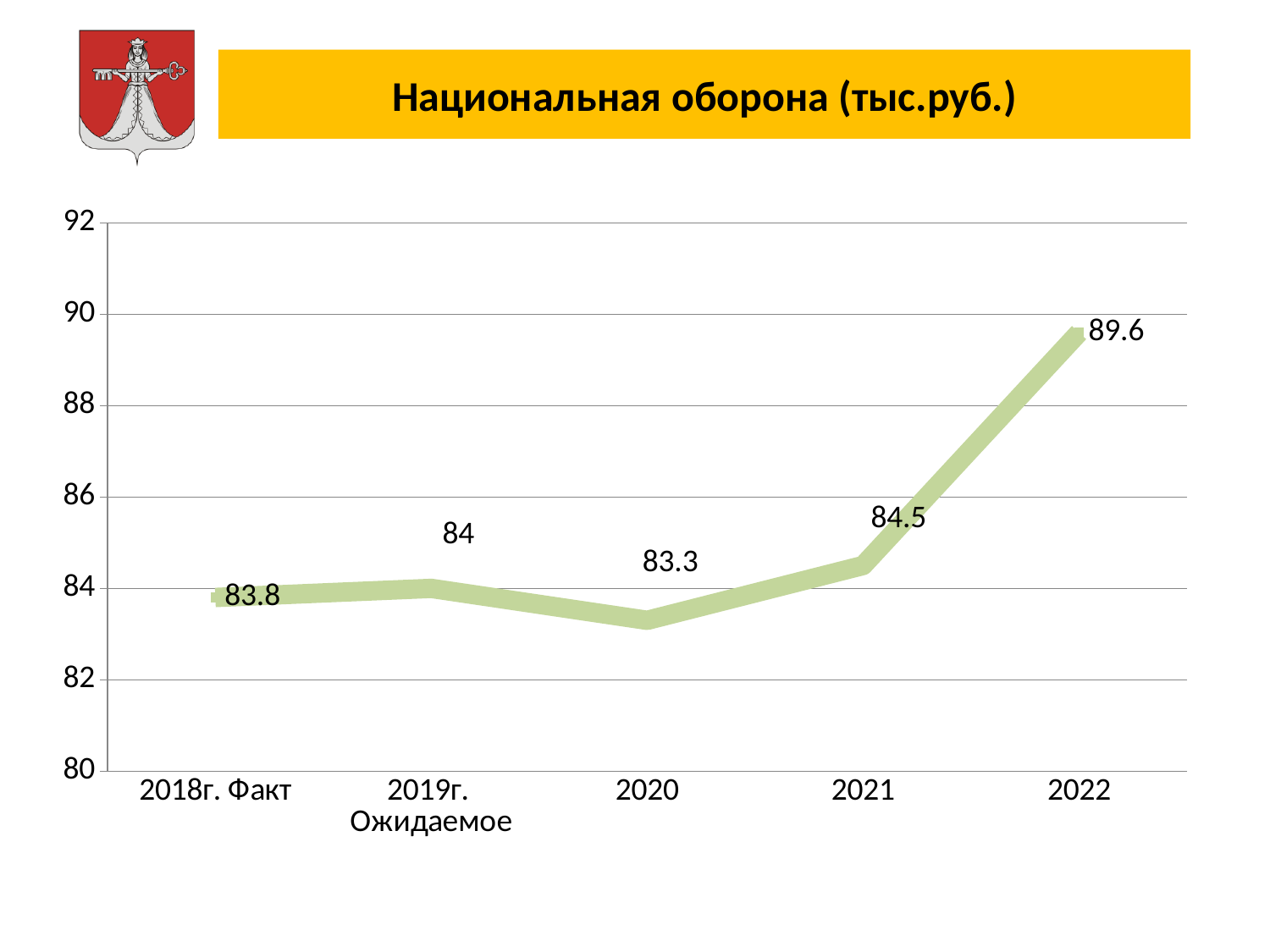
Which year has the lowest value? 2020 What is the difference between the values for 2022 and 2021? 5.1 What is the value for 2019г. Ожидаемое? 84 Which is larger, the value for 2021 or the value for 2020? 2021 What is the value for 2022? 89.6 How many data points are plotted on the chart? 5 What is the title of the chart? Национальная оборона (тыс.руб.) What is the value for 2018г. Факт? 83.8 What kind of chart is shown on the slide? line chart Which year has the highest value? 2022 What is the value for 2020? 83.3 Is the value for 2022 greater or less than 88? greater